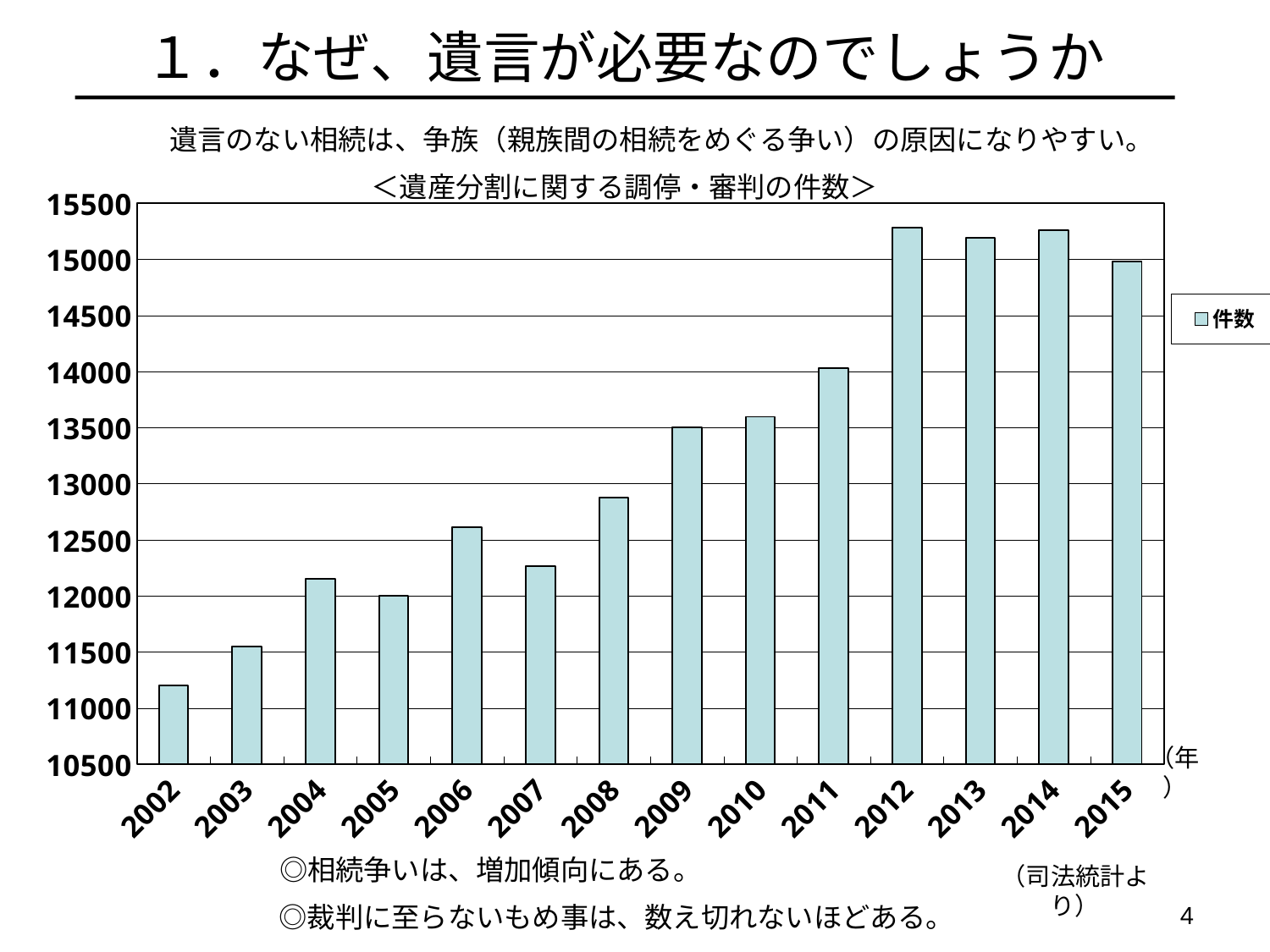
Is the value for 2008 greater or less than 13000? less Which year has the lowest value in the chart? 2002 Is the value for 2002 greater or less than 11500? less How many series does the chart's legend list? 1 Overall, do the values rise or fall from 2002 to 2015? rise What is the series name shown in the chart's legend? 件数 Is the value for 2012 greater or less than 15000? greater What kind of chart is shown on the slide? bar chart How many years are shown on the x axis of the chart? 14 Which is larger, the value for 2011 or the value for 2012? 2012 Which is larger, the value for 2006 or the value for 2007? 2006